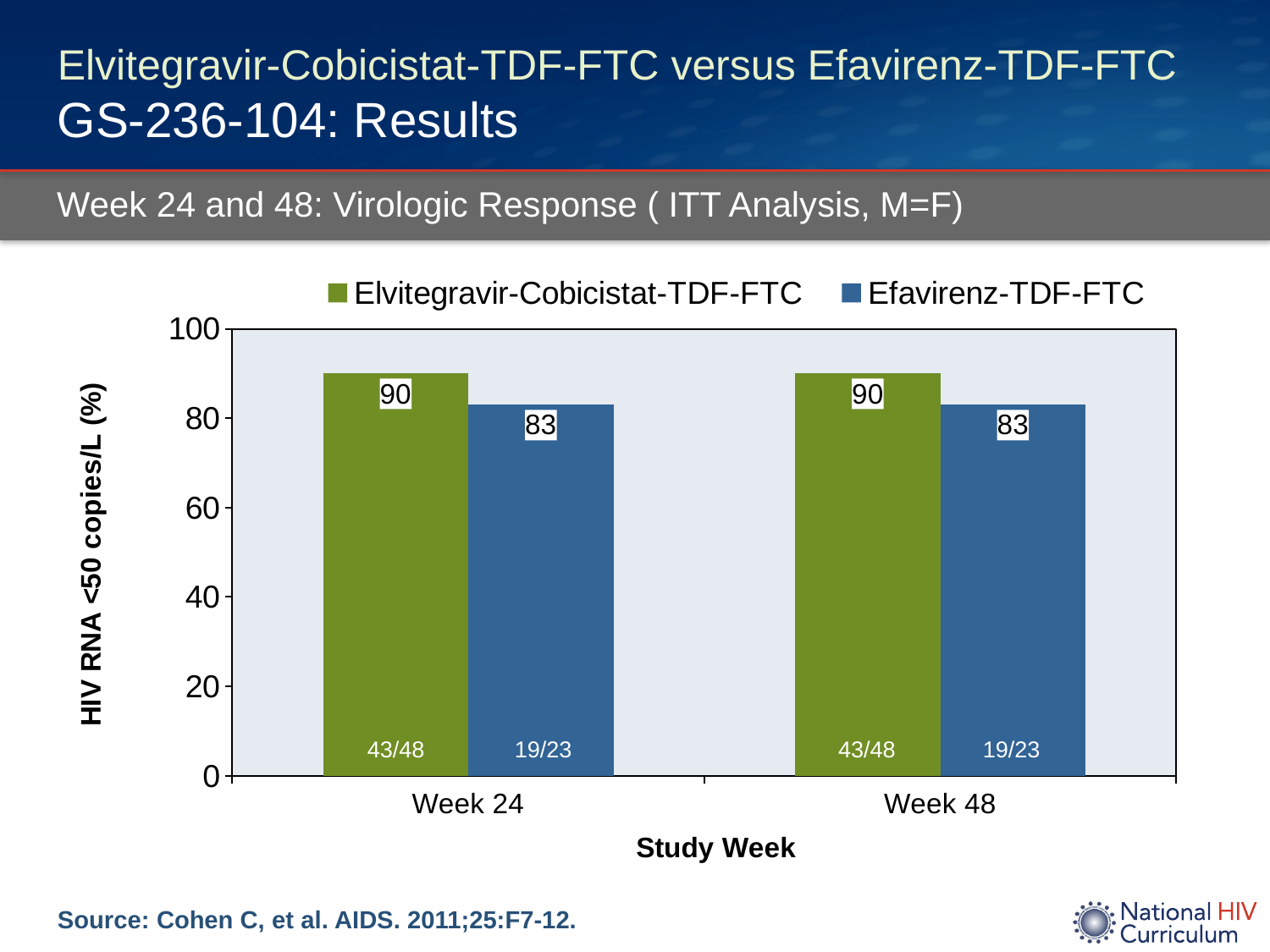
How many series does the legend list? 2 How many study week categories are shown on the x axis? 2 Is the value for Efavirenz-TDF-FTC at Week 48 greater or less than 80? greater What is the difference between the Elvitegravir-Cobicistat-TDF-FTC and Efavirenz-TDF-FTC values at Week 48? 7 What is the label of the y axis? HIV RNA <50 copies/L (%) What is the value for Efavirenz-TDF-FTC at Week 24? 83 What is the value for Efavirenz-TDF-FTC at Week 48? 83 What fraction of patients is shown inside the Elvitegravir-Cobicistat-TDF-FTC bar at Week 48? 43/48 Which series has the larger value at Week 24, Elvitegravir-Cobicistat-TDF-FTC or Efavirenz-TDF-FTC? Elvitegravir-Cobicistat-TDF-FTC What is the value for Elvitegravir-Cobicistat-TDF-FTC at Week 24? 90 What kind of chart is shown on the slide? bar chart What fraction of patients is shown inside the Efavirenz-TDF-FTC bar at Week 24? 19/23